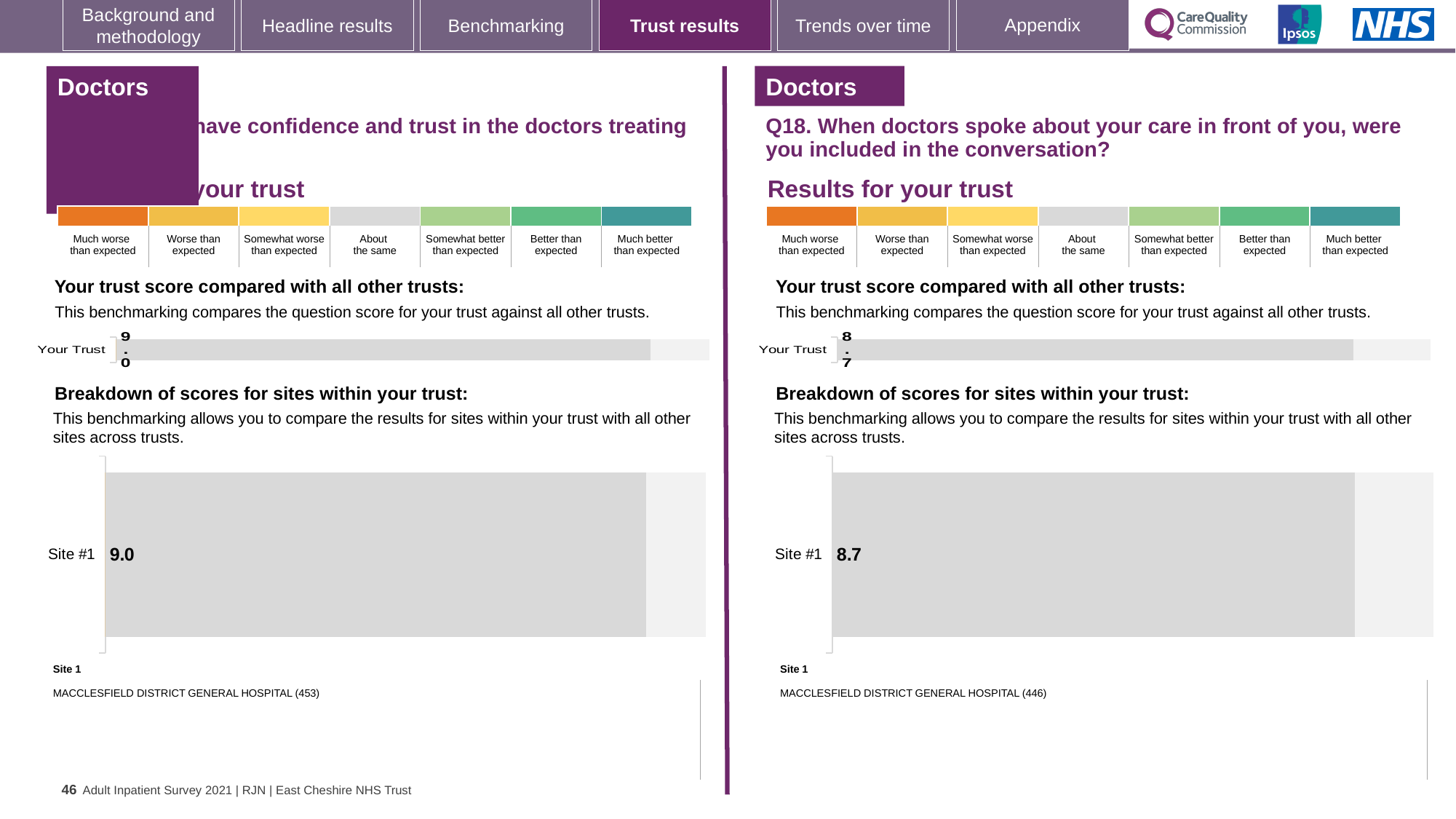
Which is larger: the Your Trust score on the left half of the slide or the Your Trust score on the right half (Q18)? Left (9.0) What type of chart is used to show the Site #1 score on the right half of the slide? Bar chart In the right 'Breakdown of scores for sites within your trust' chart (Q18), what is the score for Site #1? 8.7 Which hospital is listed as Site 1 on the right half of the slide (Q18)? MACCLESFIELD DISTRICT GENERAL HOSPITAL (446) On the right half of the slide (Q18), what is the score shown for Your Trust? 8.7 What is the question text shown above the charts on the right half of the slide? Q18. When doctors spoke about your care in front of you, were you included in the conversation? What is the difference between the Site #1 score on the left half of the slide and the Site #1 score on the right half (Q18)? 0.3 In the left 'Breakdown of scores for sites within your trust' chart, what is the score for Site #1? 9.0 On the left half of the slide, what is the score shown for Your Trust? 9.0 How many sites are shown in the left 'Breakdown of scores for sites within your trust' chart? 1 How many sites are shown in the right 'Breakdown of scores for sites within your trust' chart (Q18)? 1